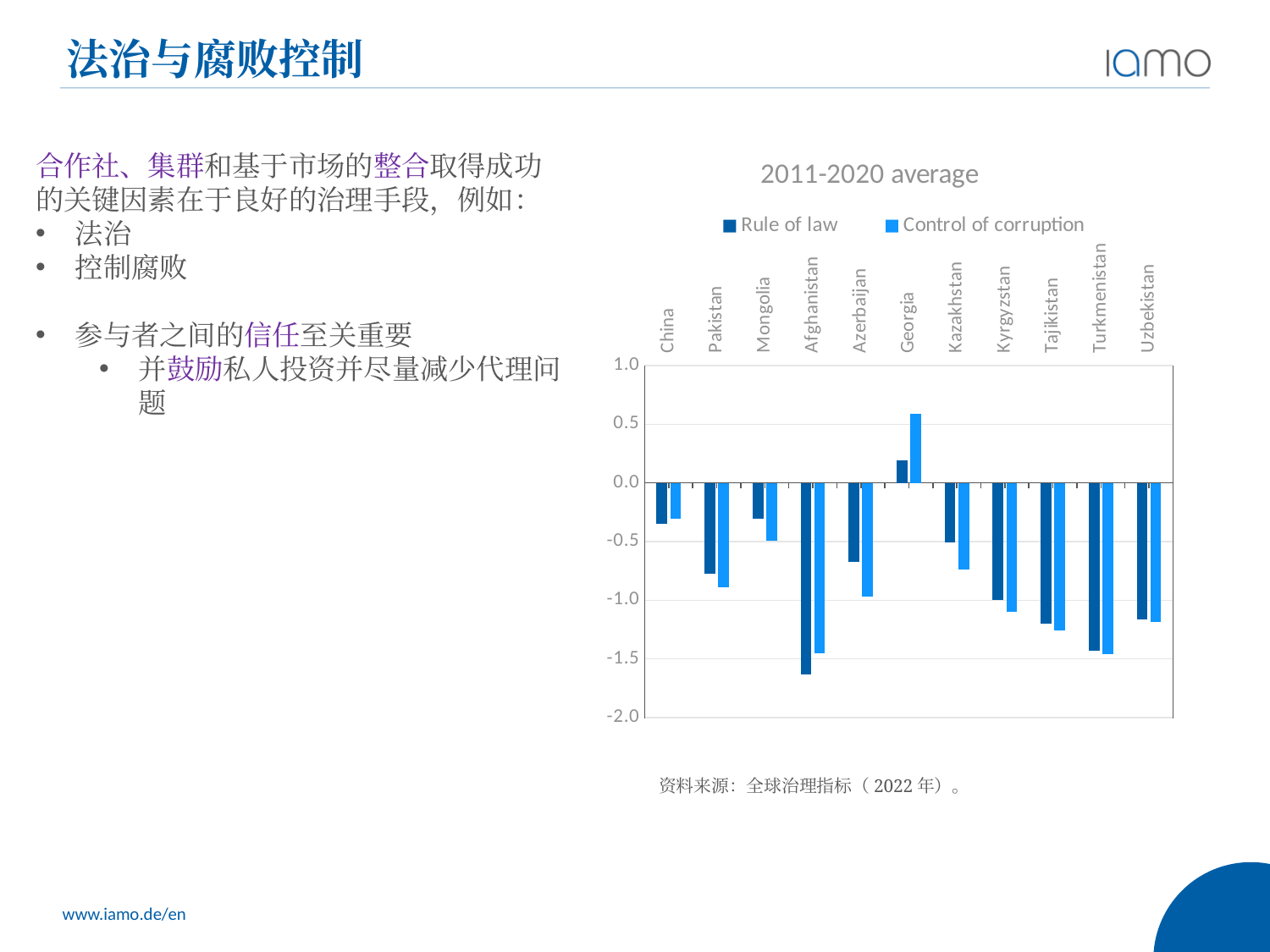
What kind of chart is shown on the slide? bar chart Which two series are listed in the chart's legend? Rule of law and Control of corruption How many countries are shown on the x axis of the chart? 11 Which country has the lowest Rule of law value? Afghanistan Which is larger, the Control of corruption value for Georgia or for Pakistan? Georgia What is the title of the chart? 2011-2020 average Is the Rule of law value for Afghanistan greater or less than -1.5? less Which country has the highest Control of corruption value? Georgia Which country has the highest Rule of law value? Georgia How many series does the chart's legend list? 2 Is the Control of corruption value for Georgia greater or less than 0.5? greater Is the Rule of law value for China greater or less than -0.5? greater